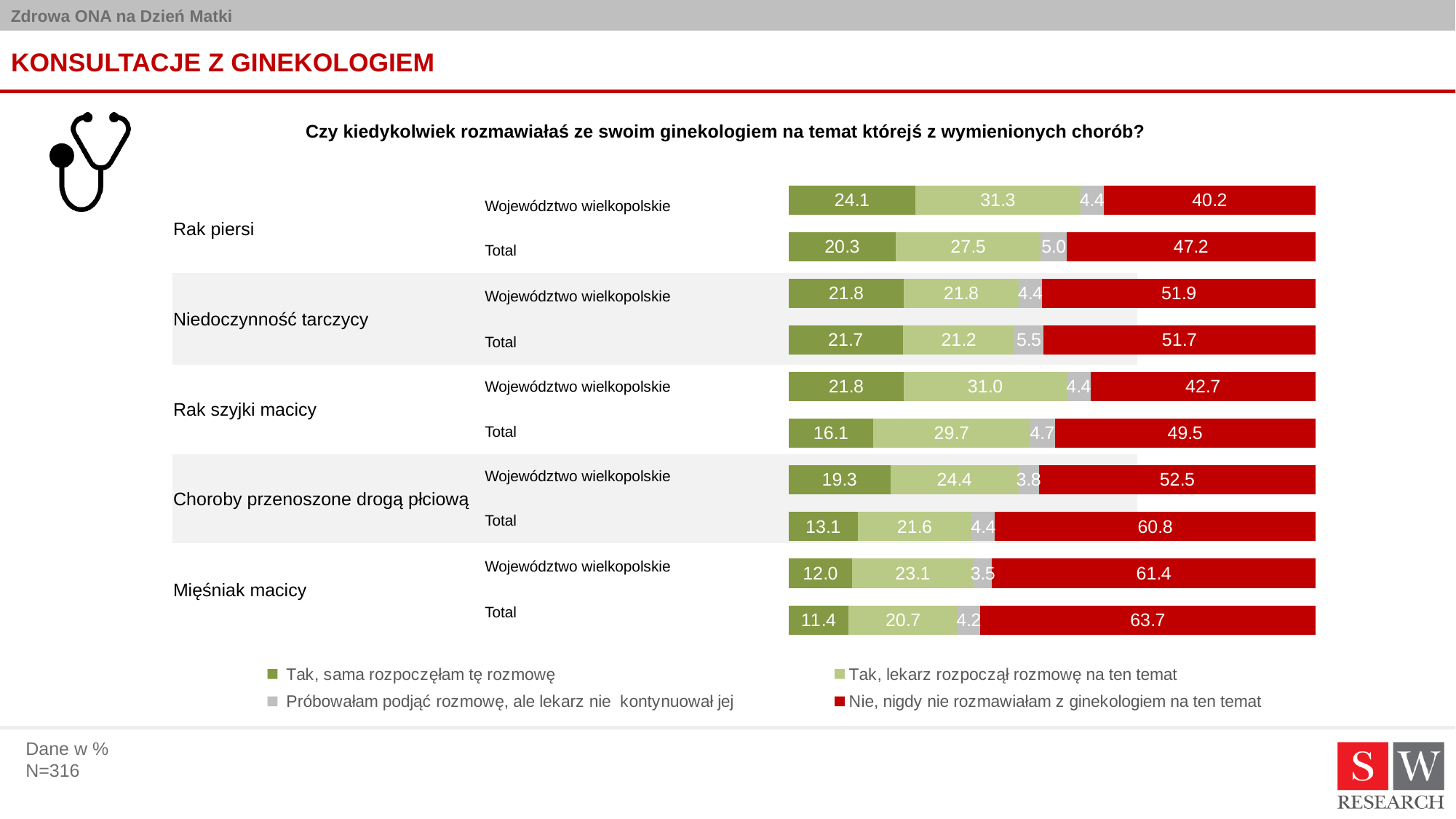
What is the value for "Tak, sama rozpoczęłam tę rozmowę" in the Województwo wielkopolskie bar for Rak piersi? 24.1 What is the value for "Nie, nigdy nie rozmawiałam z ginekologiem na ten temat" in the Total bar for Mięśniak macicy? 63.7 For Rak szyjki macicy, which group has the larger value for "Tak, lekarz rozpoczął rozmowę na ten temat": Województwo wielkopolskie or Total? Województwo wielkopolskie For Choroby przenoszone drogą płciową, what is the difference between the Total and Województwo wielkopolskie values for "Nie, nigdy nie rozmawiałam z ginekologiem na ten temat"? 8.3 How many bars are plotted in the chart? 10 What is the value for "Próbowałam podjąć rozmowę, ale lekarz nie kontynuował jej" in the Total bar for Niedoczynność tarczycy? 5.5 Which bar has the highest value for "Nie, nigdy nie rozmawiałam z ginekologiem na ten temat"? Mięśniak macicy, Total What kind of chart is shown on the slide? Stacked bar chart For Rak piersi, what is the difference between the Total and Województwo wielkopolskie values for "Nie, nigdy nie rozmawiałam z ginekologiem na ten temat"? 7.0 How many series does the legend list? 4 Which bar has the lowest value for "Tak, sama rozpoczęłam tę rozmowę"? Mięśniak macicy, Total What is the total of the Województwo wielkopolskie bar for Rak piersi? 100.0